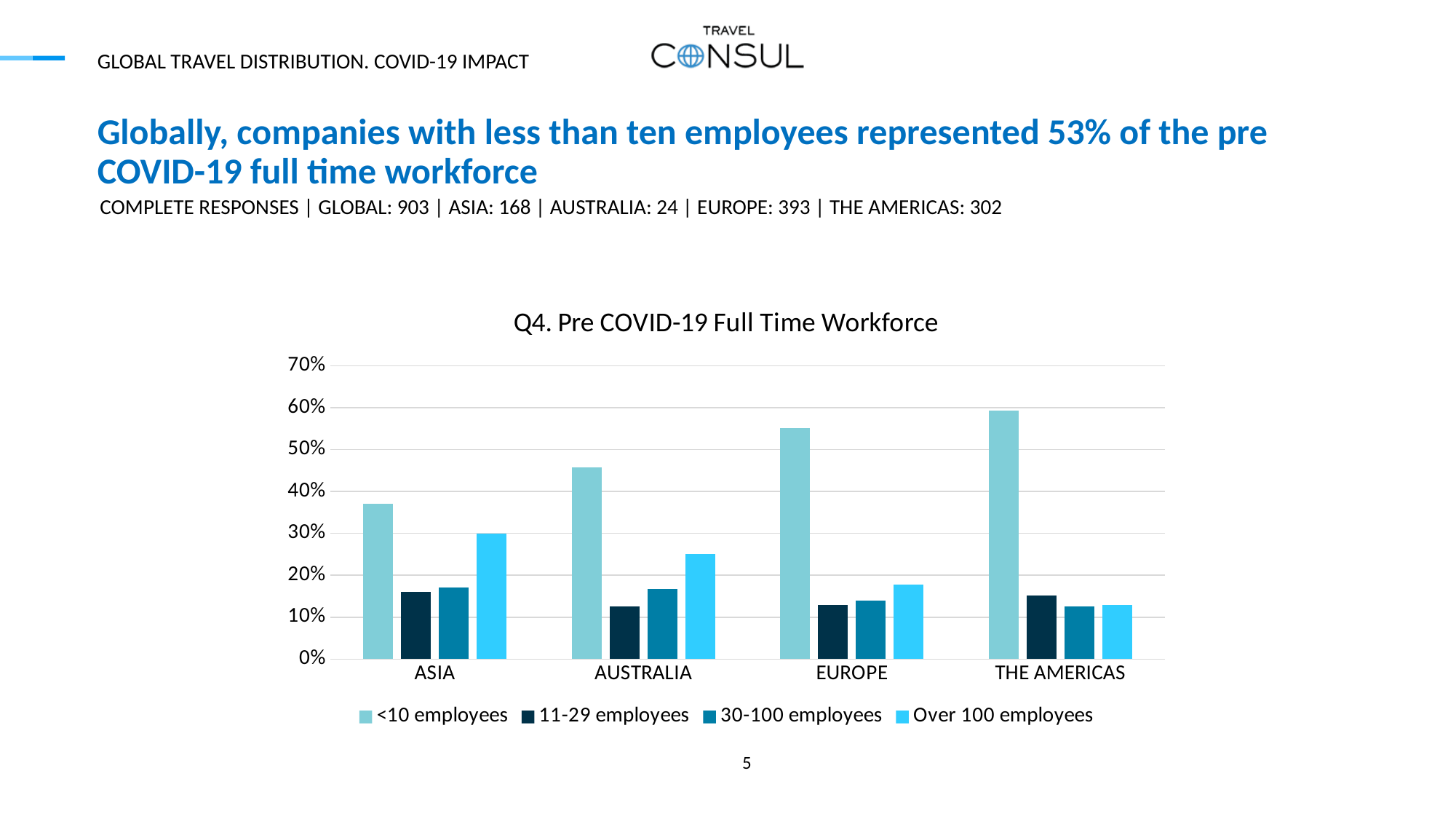
What kind of chart is shown on the slide? bar chart Is the value for <10 employees in Asia greater or less than 40%? less Which region has the highest value for Over 100 employees? Asia Which is larger: the Over 100 employees value for Asia or for Europe? Asia Which region has the highest value for <10 employees? The Americas How many series does the legend of the Q4 chart list? 4 Is the value for Over 100 employees in Australia greater or less than 20%? greater How many regions are shown on the x axis of the Q4 chart? 4 Is the value for <10 employees in Europe greater or less than 50%? greater What is the title of the chart? Q4. Pre COVID-19 Full Time Workforce Do the values for <10 employees rise or fall from Asia to The Americas along the x axis? rise Which region has the lowest value for <10 employees? Asia